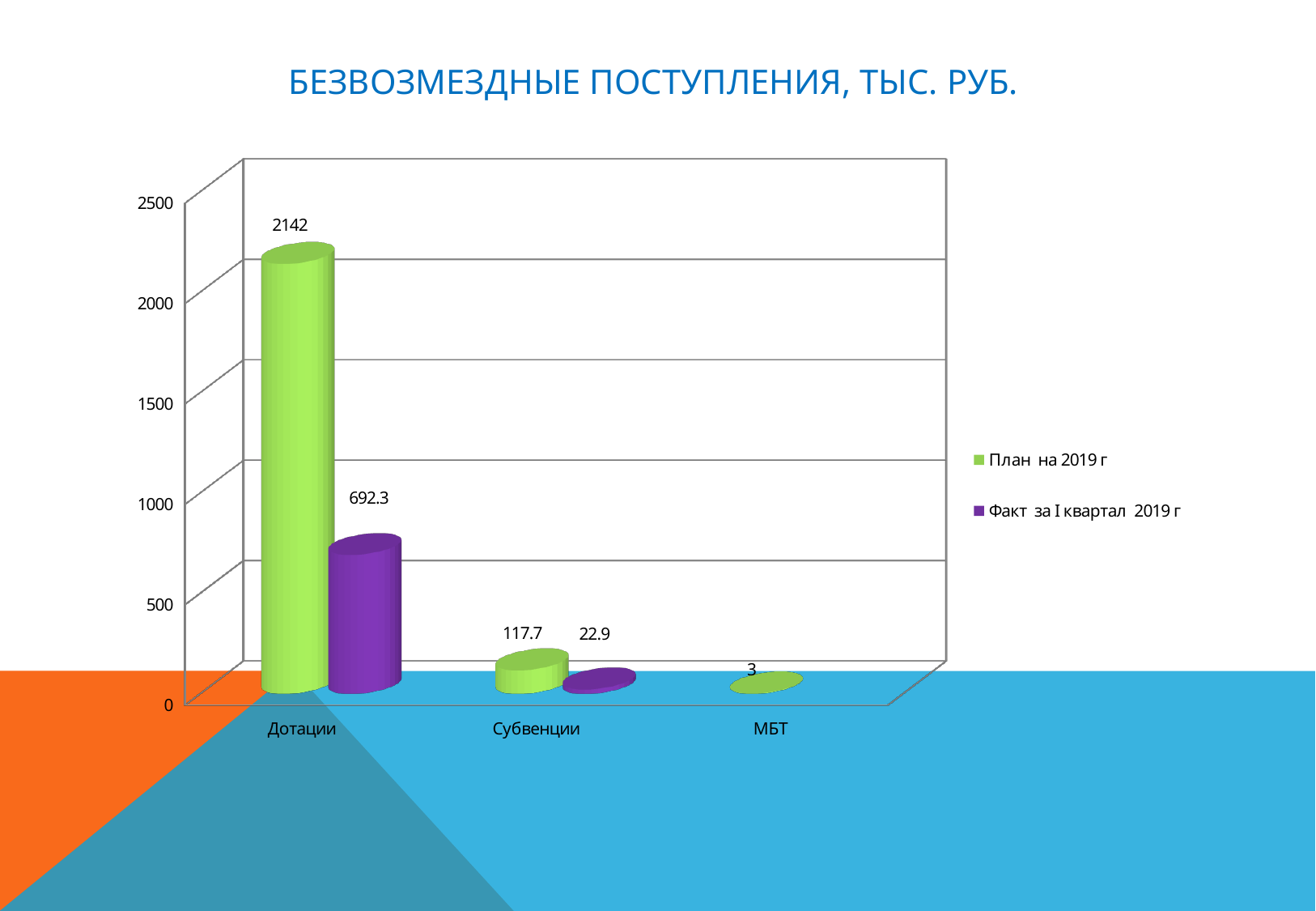
Which is larger: Факт за I квартал 2019 г for Дотации or План на 2019 г for Субвенции? Факт за I квартал 2019 г for Дотации What is the value of Факт за I квартал 2019 г for Субвенции? 22.9 Which category has the lowest value for План на 2019 г? МБТ What is the difference between План на 2019 г and Факт за I квартал 2019 г for Субвенции? 94.8 What is the difference between План на 2019 г and Факт за I квартал 2019 г for Дотации? 1449.7 Which category has the highest value for План на 2019 г? Дотации What kind of chart is shown on the slide? Bar chart How many series does the legend list? 2 What is the value of План на 2019 г for МБТ? 3 What is the value of План на 2019 г for Дотации? 2142 What is the value of Факт за I квартал 2019 г for Дотации? 692.3 What is the value of План на 2019 г for Субвенции? 117.7